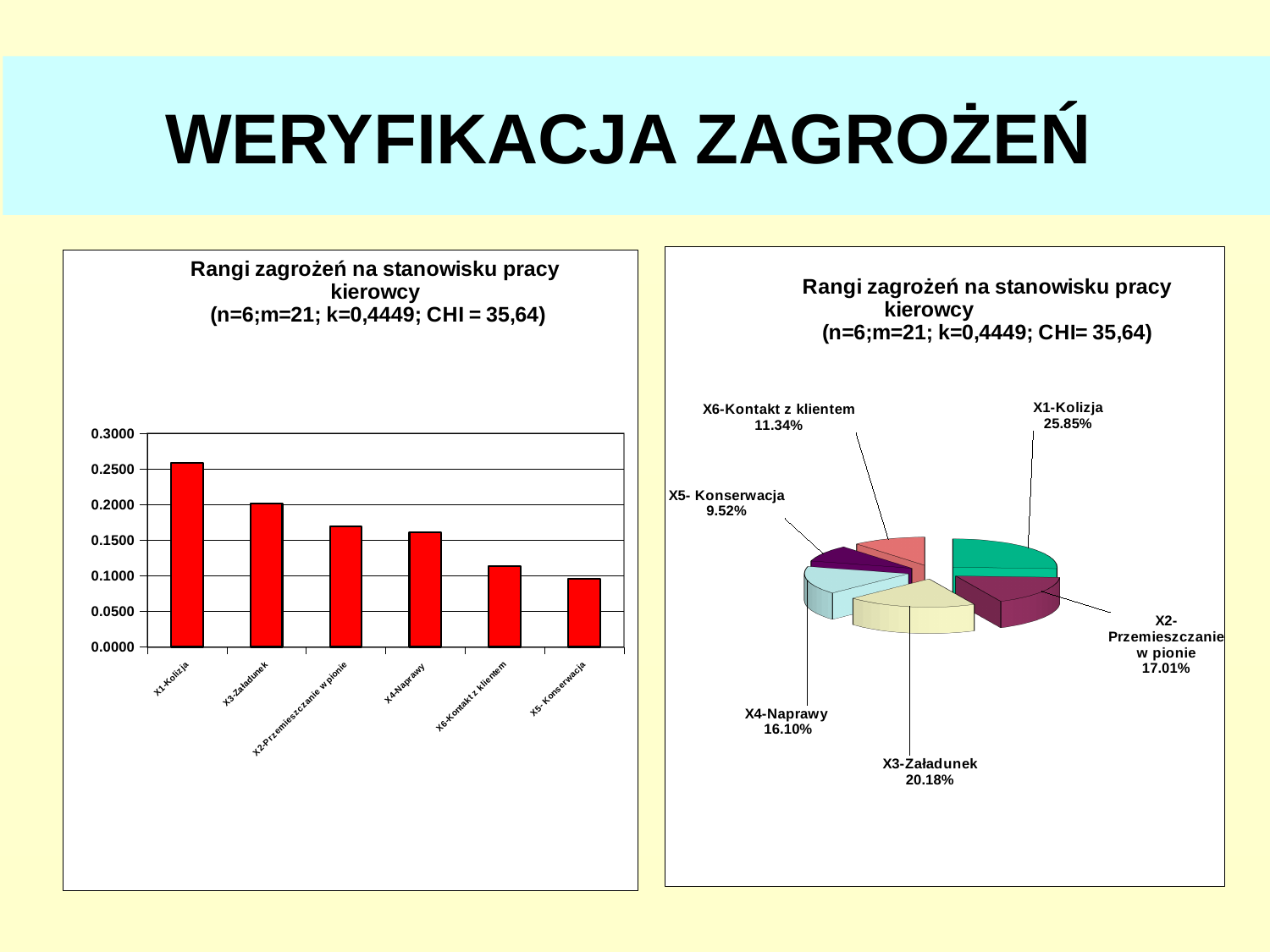
In the bar chart on the left, how many categories are shown on the x axis? 6 In the pie chart on the right, what is the difference between the shares of X4-Naprawy and X6-Kontakt z klientem? 4.76% In the bar chart on the left, is the value for X2-Przemieszczanie w pionie greater or less than 0.1500? greater What kind of chart is the chart on the right of the slide? pie chart In the pie chart on the right, what share does X3-Załadunek have? 20.18% What kind of chart is the chart on the left of the slide? bar chart In the bar chart on the left, do the bar values rise or fall from left to right along the x axis? fall In the pie chart on the right, what share does X1-Kolizja have? 25.85% In the bar chart on the left, which category has the highest bar? X1-Kolizja In the pie chart on the right, which slice is the smallest? X5- Konserwacja In the bar chart on the left, is the value for X1-Kolizja greater or less than 0.2500? greater In the bar chart on the left, which category has the lowest bar? X5-Konserwacja